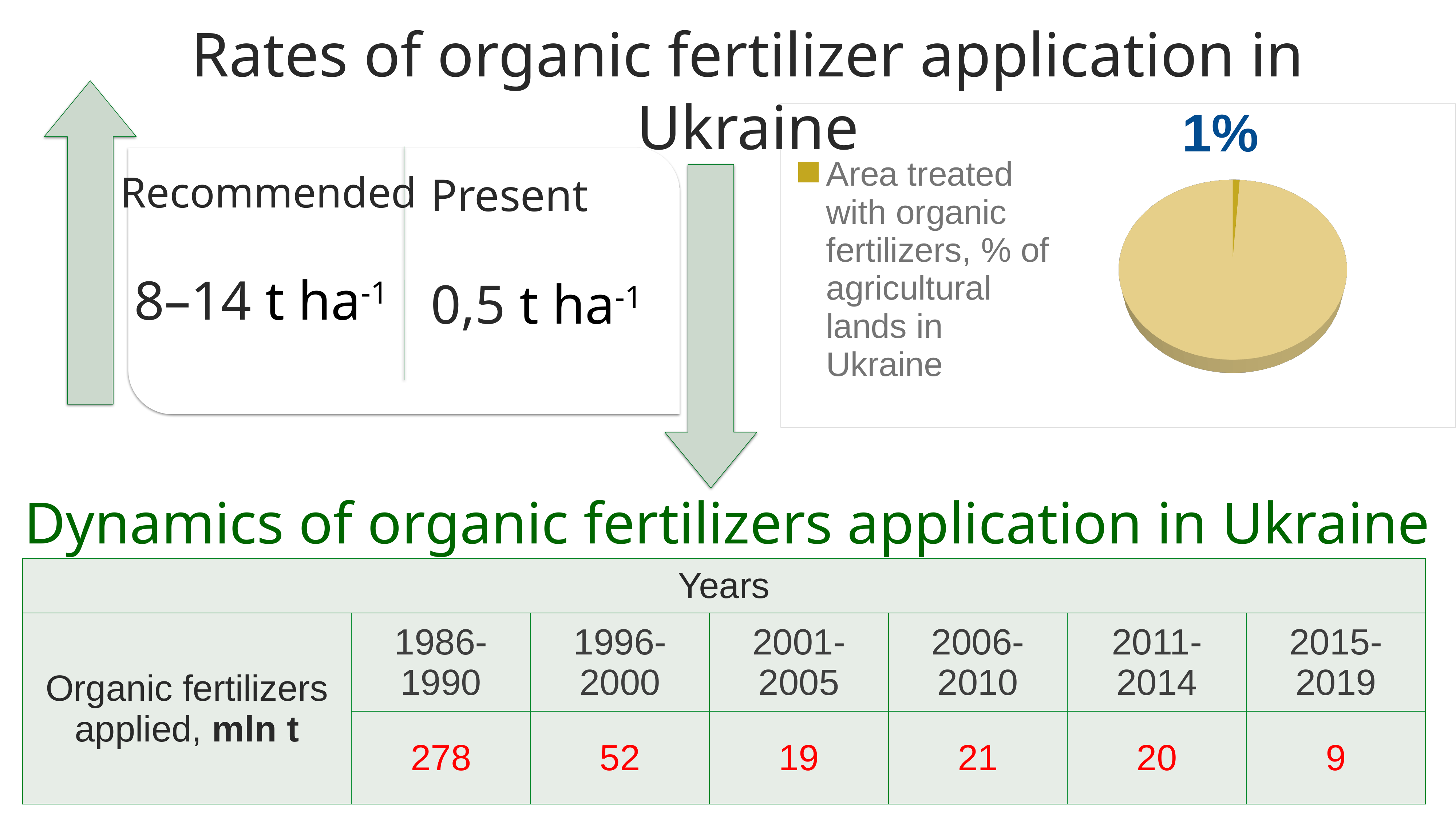
What kind of chart is shown in the top right of the slide? pie chart How many entries does the legend of the pie chart list? 1 What value is printed as the data label on the pie chart? 1% According to the pie chart, what share of agricultural lands in Ukraine is treated with organic fertilizers? 1% Is the labelled 1% slice of the pie chart larger or smaller than the remaining part of the pie? smaller What does the legend entry of the pie chart say? Area treated with organic fertilizers, % of agricultural lands in Ukraine What colour is the pie chart drawn in? gold/yellow How many slices of the pie chart carry a printed data label? 1